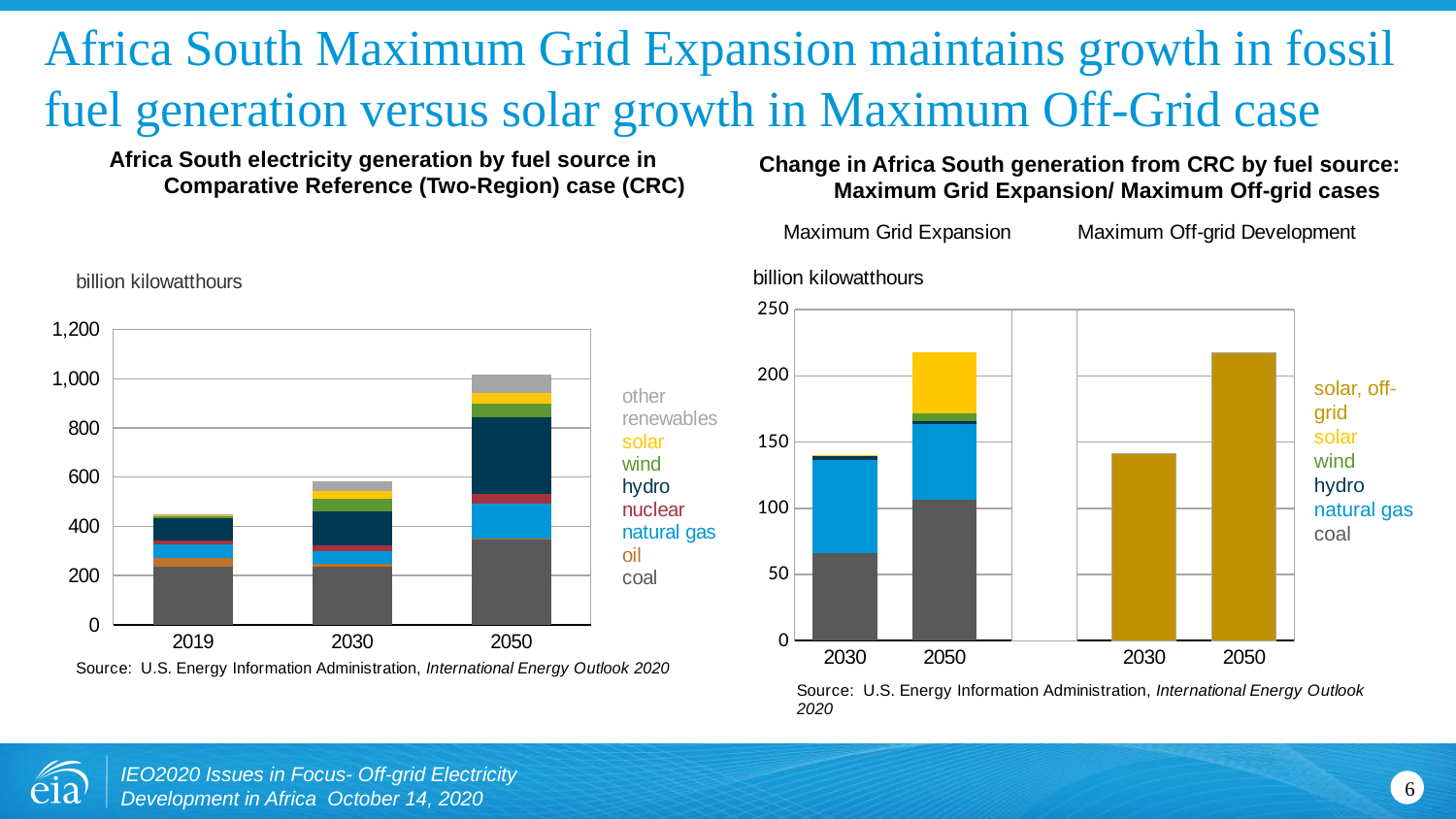
In the right chart (Change in Africa South generation from CRC), how many fuel sources does the legend list? 6 In the left chart (CRC generation by fuel source), is the total generation for 2019 greater or less than 600 billion kilowatthours? less In the left chart (CRC generation by fuel source), does total generation rise or fall from 2019 to 2050? rise In the right chart (Change in Africa South generation from CRC), which fuel source makes up the Maximum Off-grid Development bars? solar, off-grid In the left chart (CRC generation by fuel source), is the total generation for 2050 greater or less than 800 billion kilowatthours? greater In the left chart (CRC generation by fuel source), which year has the highest total generation? 2050 In the right chart (Change in Africa South generation from CRC), is the 2030 total for Maximum Off-grid Development greater or less than 150 billion kilowatthours? less What type of chart is the left chart, 'Africa South electricity generation by fuel source in Comparative Reference (Two-Region) case (CRC)'? stacked bar chart In the left chart (CRC generation by fuel source), which year has the lowest total generation? 2019 In the left chart (CRC generation by fuel source), how many years are shown on the x axis? 3 In the left chart (CRC generation by fuel source), how many fuel sources does the legend list? 8